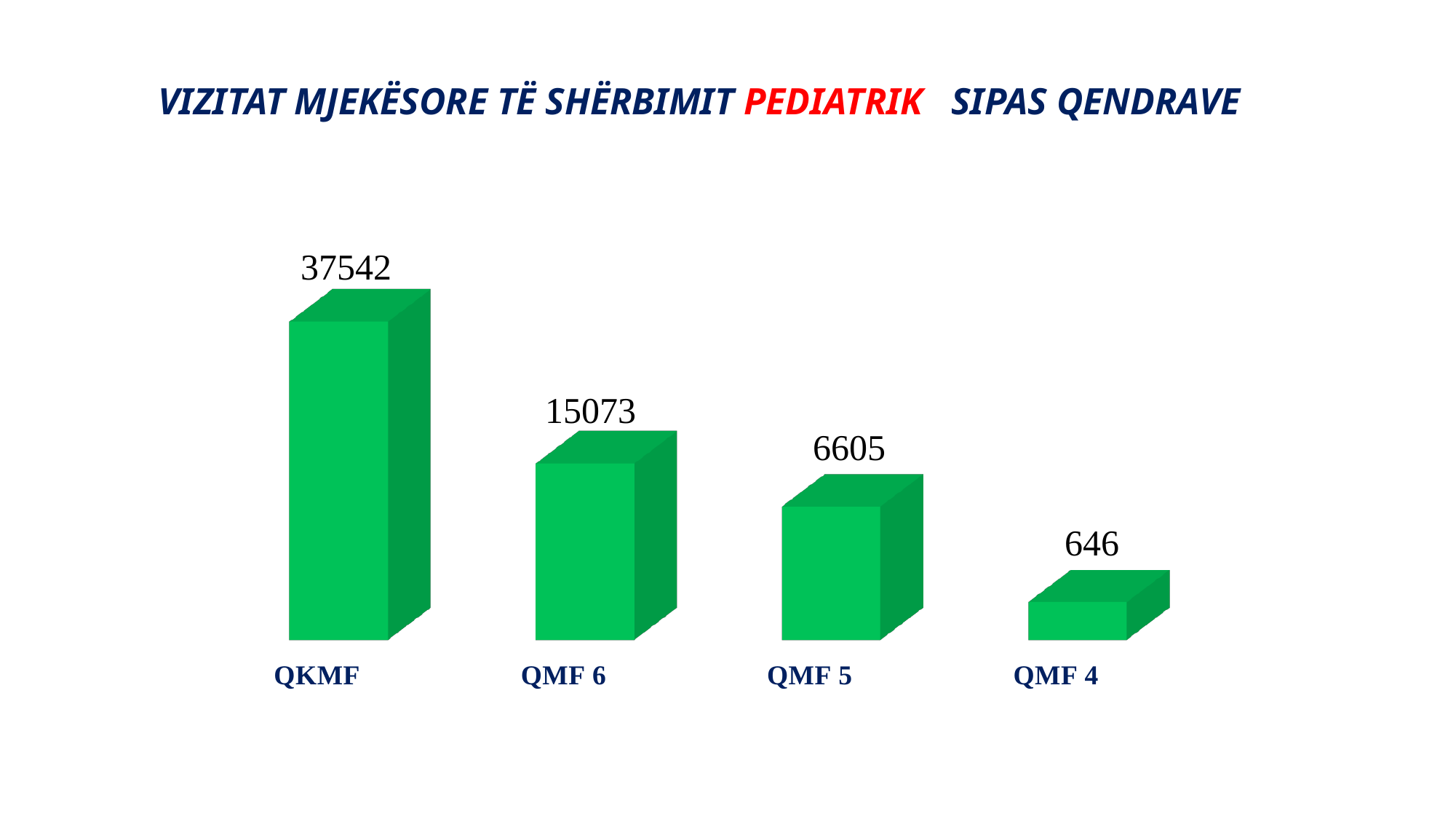
What is the difference between the values for QMF 5 and QMF 4? 5959 Which category has the lowest value? QMF 4 Which category has the highest value? QKMF What is the value for QMF 6? 15073 How many categories are shown in the chart? 4 Do the values rise or fall from left to right along the x axis? fall What kind of chart is shown on the slide? bar chart What is the value for QMF 4? 646 What is the difference between the values for QKMF and QMF 6? 22469 What is the value for QMF 5? 6605 Which is larger, the value for QMF 6 or the value for QMF 5? QMF 6 What is the value for QKMF? 37542